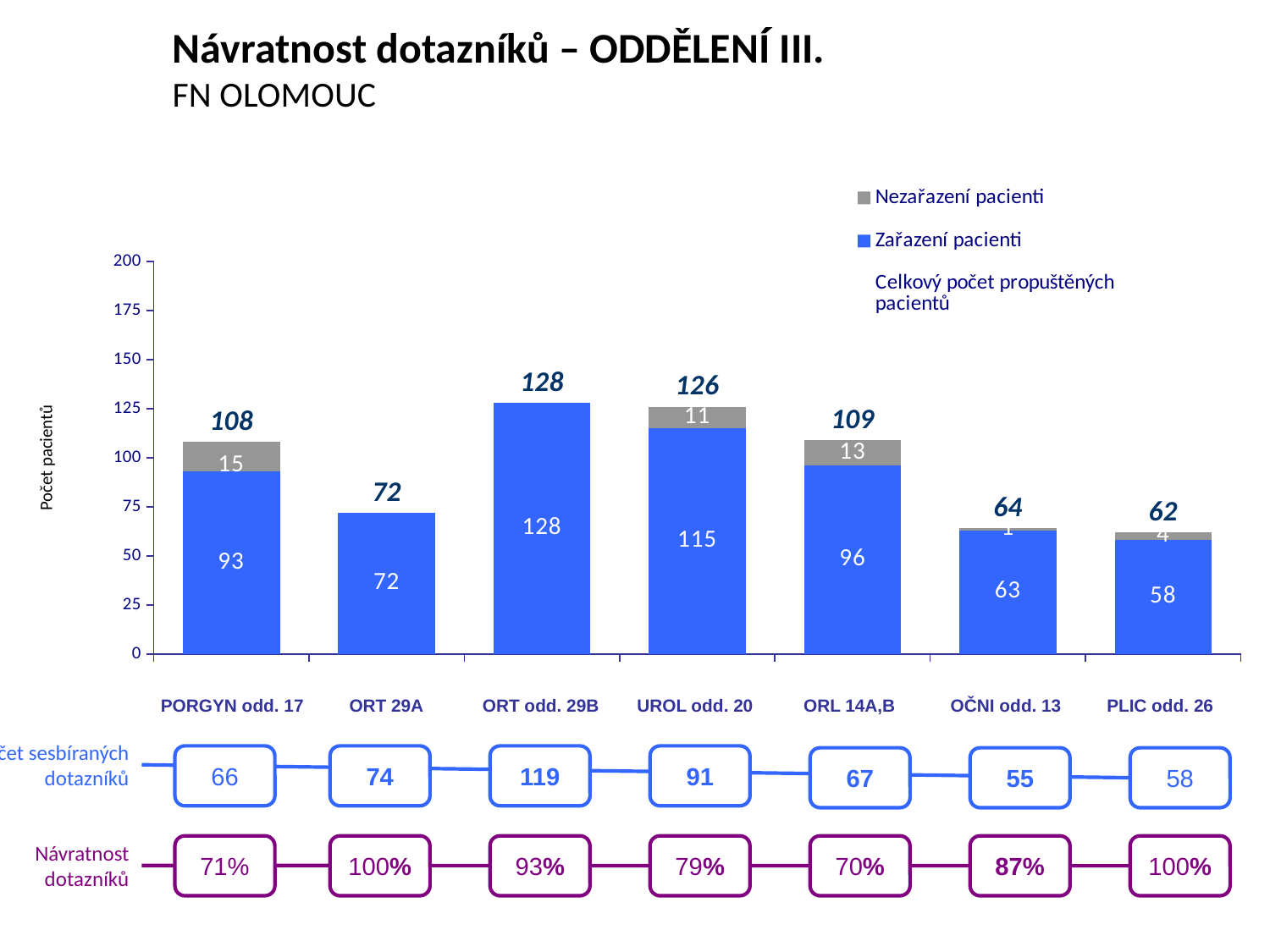
What type of chart is shown on the slide? stacked bar chart Which department has the highest total number of discharged patients? ORT odd. 29B What is the value of Nezařazení pacienti for PORGYN odd. 17? 15 How many series does the chart legend list? 3 Is the total number of discharged patients for OČNI odd. 13 greater or less than 75? less What is the Návratnost dotazníků (return rate) shown for UROL odd. 20? 79% What is the difference between the Zařazení pacienti values for ORT odd. 29B and ORT 29A? 56 Which department has the lowest total number of discharged patients? PLIC odd. 26 What is the value of Zařazení pacienti for UROL odd. 20? 115 Which is larger, the Nezařazení pacienti value for UROL odd. 20 or for ORL 14A,B? ORL 14A,B How many departments (categories) are shown on the x axis of the chart? 7 What is the total number of discharged patients (Celkový počet propuštěných pacientů) for ORL 14A,B? 109